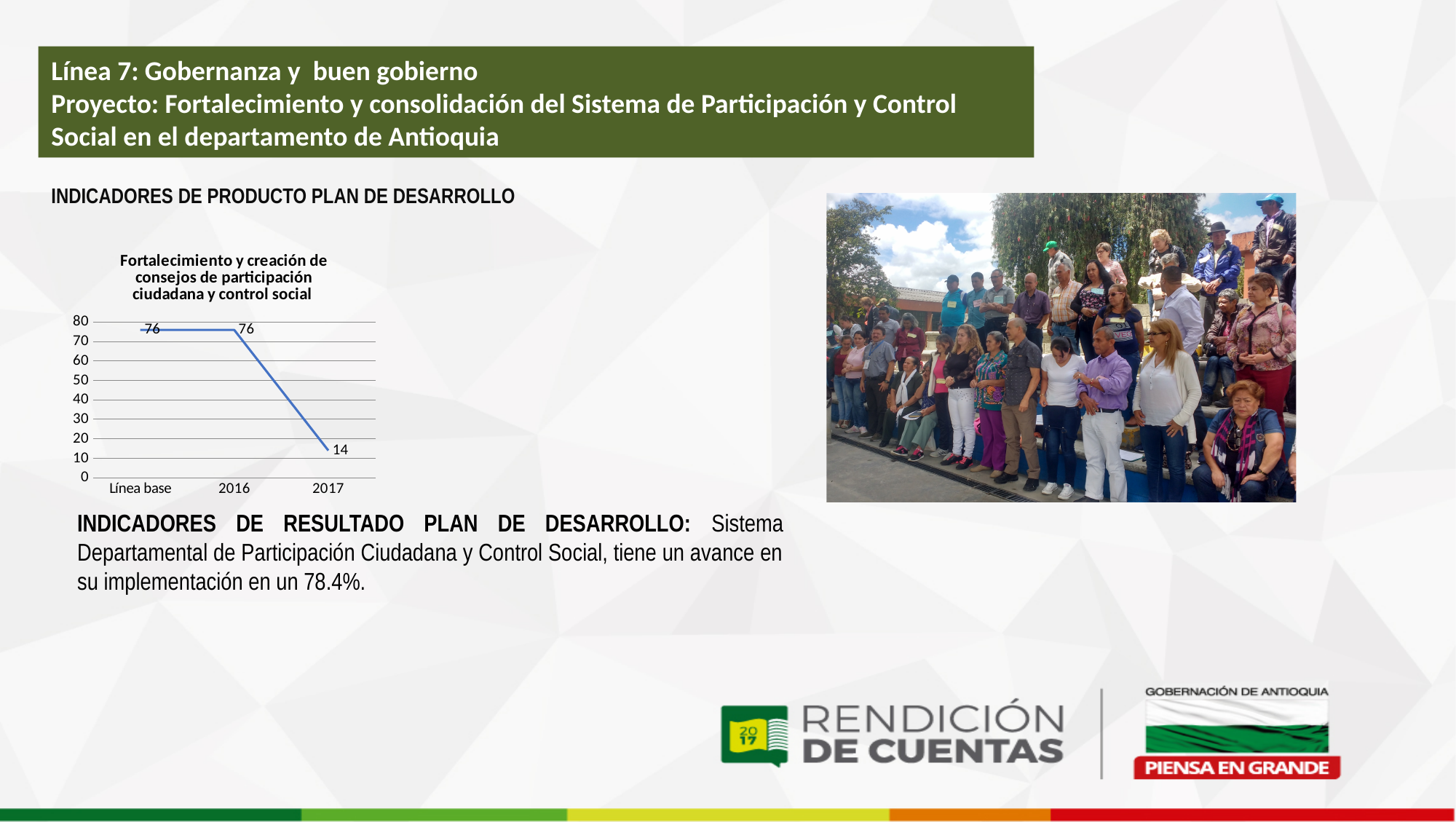
What is the title of the chart? Fortalecimiento y creación de consejos de participación ciudadana y control social What is the value for 2017 in the chart? 14 Do the values rise or fall from 2016 to 2017? fall What is the value for Línea base in the chart? 76 What is the maximum value shown on the y axis of the chart? 80 Which is larger, the value for Línea base or the value for 2017? Línea base What kind of chart is shown on the slide? line chart Is the value for 2017 greater or less than 20? less Which category has the lowest value in the chart? 2017 How many categories are shown on the x axis of the chart? 3 What is the value for 2016 in the chart? 76 What is the difference between the value for 2016 and the value for 2017? 62